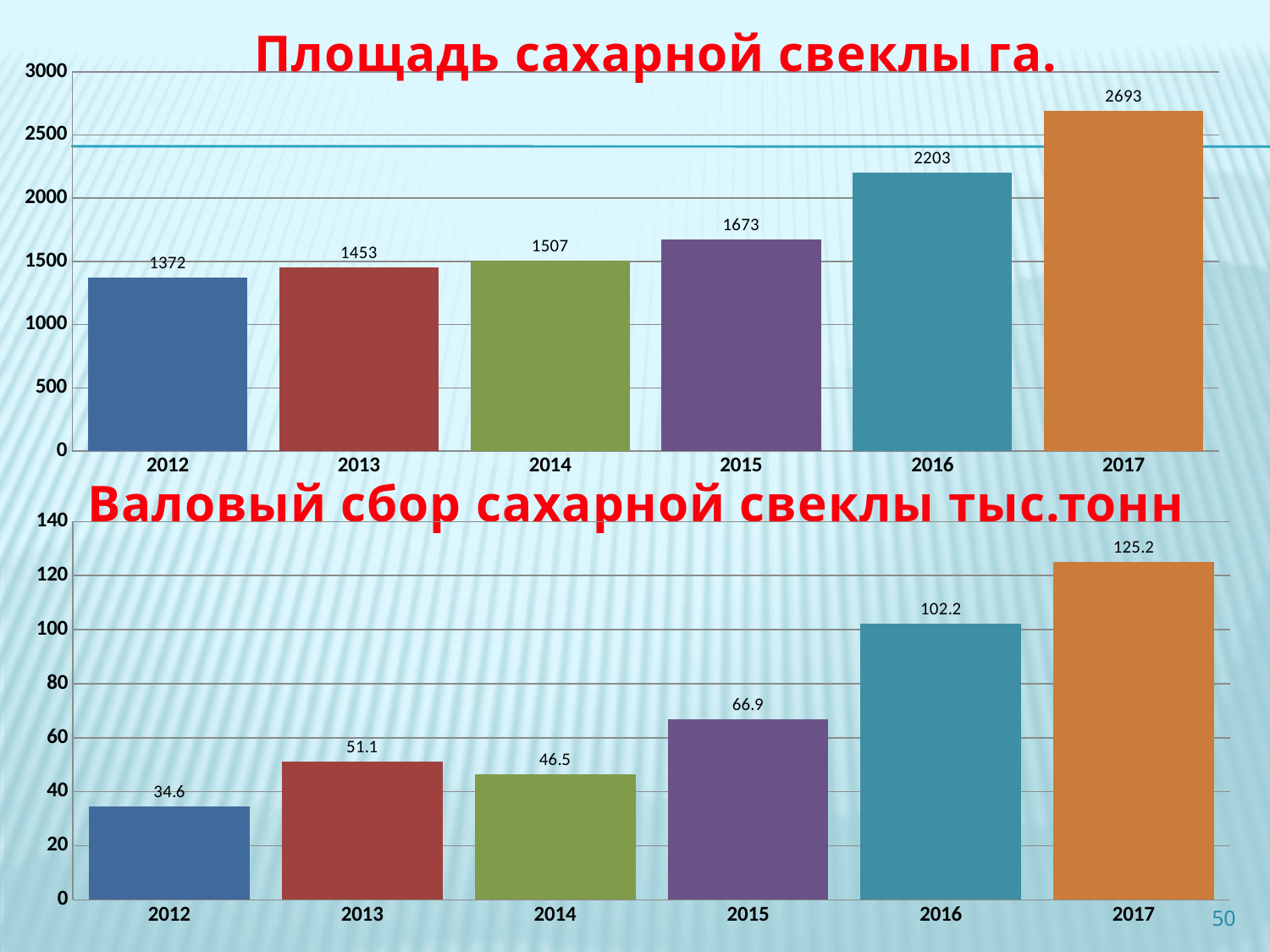
In the bottom chart 'Валовый сбор сахарной свеклы тыс.тонн', what is the difference between the values for 2017 and 2012? 90.6 What is the title of the top chart on the slide? Площадь сахарной свеклы га. In the bottom chart 'Валовый сбор сахарной свеклы тыс.тонн', is the value for 2016 greater or less than 100? greater What kind of chart is the bottom chart 'Валовый сбор сахарной свеклы тыс.тонн'? bar chart In the top chart 'Площадь сахарной свеклы га.', which year has the lowest value? 2012 In the bottom chart 'Валовый сбор сахарной свеклы тыс.тонн', what is the value for 2015? 66.9 In the top chart 'Площадь сахарной свеклы га.', what is the difference between the values for 2017 and 2016? 490 In the top chart 'Площадь сахарной свеклы га.', how many years are shown on the x axis? 6 In the top chart 'Площадь сахарной свеклы га.', what is the value for 2014? 1507 In the top chart 'Площадь сахарной свеклы га.', which year has the highest value? 2017 In the top chart 'Площадь сахарной свеклы га.', do the values rise or fall from 2012 to 2017? rise In the bottom chart 'Валовый сбор сахарной свеклы тыс.тонн', which is larger, the value for 2013 or 2014? 2013